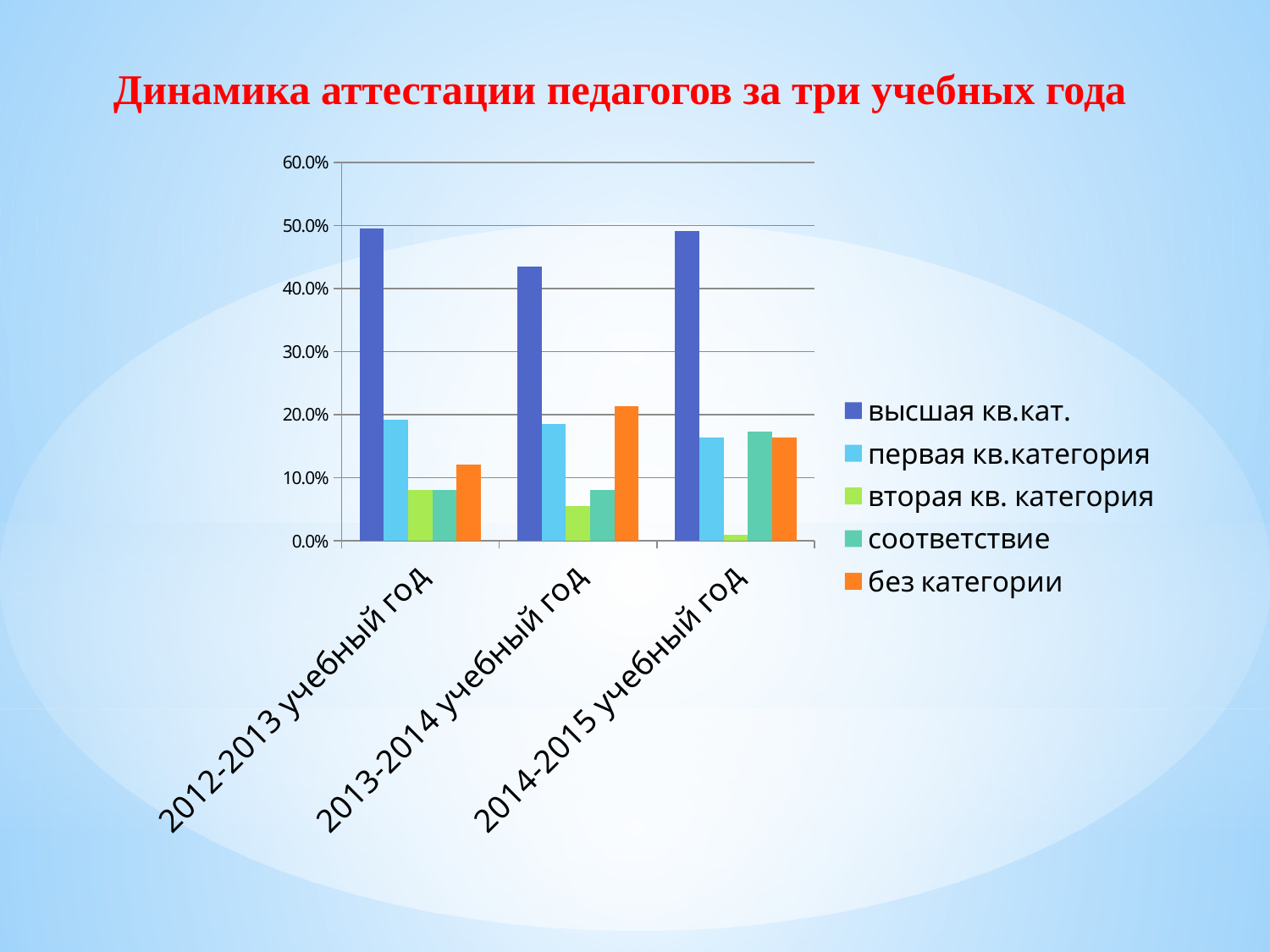
Is the value for вторая кв. категория in 2014-2015 учебный год greater or less than 10.0%? less What is the title of the slide above the chart? Динамика аттестации педагогов за три учебных года Which series has the highest value in 2013-2014 учебный год? высшая кв.кат. Does the value for вторая кв. категория rise or fall from 2012-2013 to 2014-2015? fall Is the value for без категории in 2013-2014 учебный год greater or less than 10.0%? greater How many academic years (categories) are shown on the x axis? 3 What kind of chart is shown on the slide? bar chart Which series has the lowest value in 2014-2015 учебный год? вторая кв. категория In 2012-2013 учебный год, which is larger: первая кв.категория or без категории? первая кв.категория Is the value for высшая кв.кат. in 2012-2013 учебный год greater or less than 40.0%? greater How many series does the legend list? 5 For высшая кв.кат., which year has the larger value: 2012-2013 учебный год or 2013-2014 учебный год? 2012-2013 учебный год